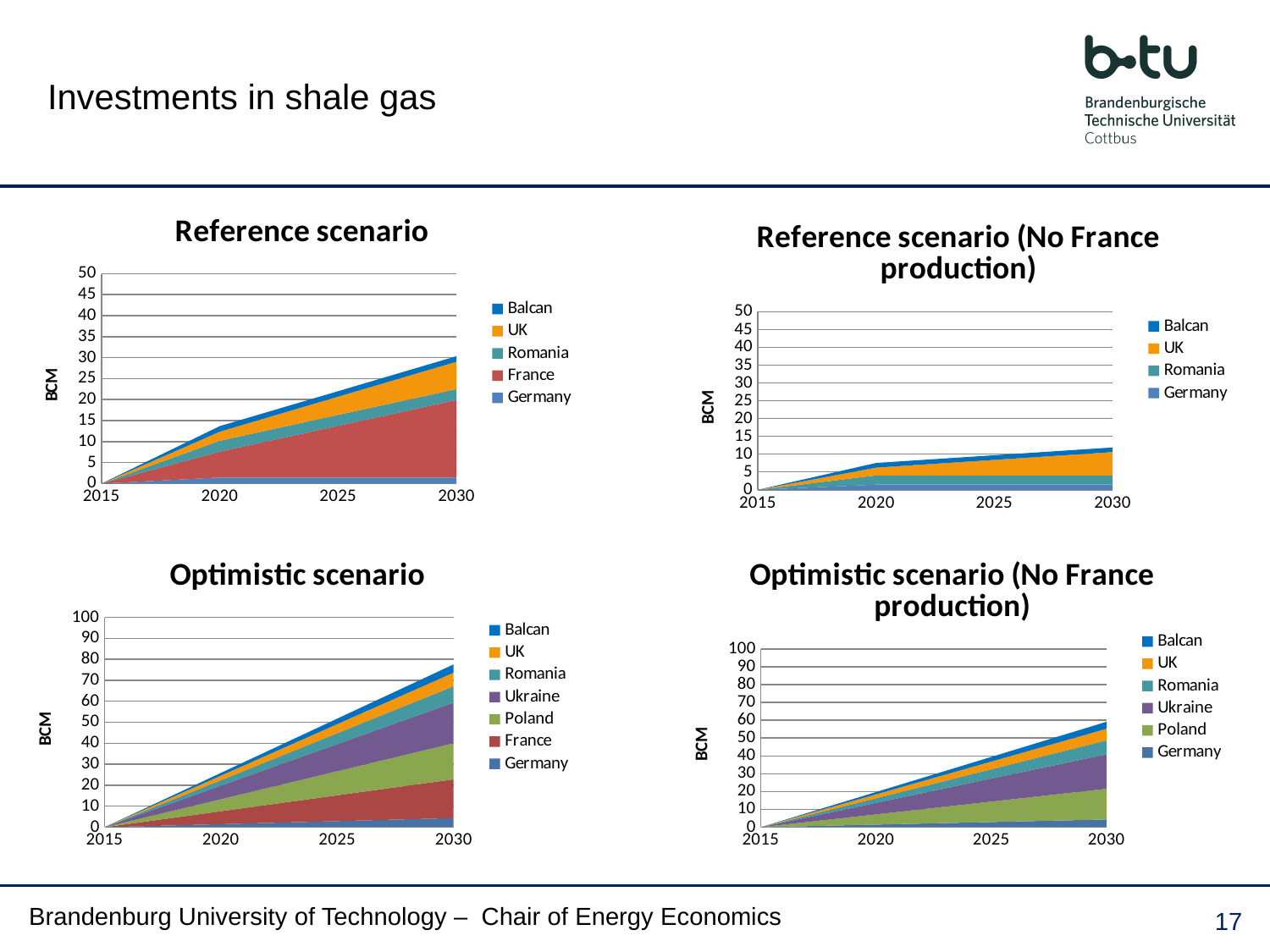
In the Optimistic scenario chart, is the total stacked value in 2030 greater or less than 60? greater In the Optimistic scenario (No France production) chart, is the total stacked value in 2030 greater or less than 70? less How many series does the legend of the Optimistic scenario chart list? 7 Which chart has the larger total stacked value in 2030, the Reference scenario chart or the Optimistic scenario chart? Optimistic scenario How many series does the legend of the Reference scenario (No France production) chart list? 4 What is the y-axis label on the Reference scenario chart? BCM How many series does the legend of the Reference scenario chart list? 5 In the Reference scenario chart, does the total stacked value rise or fall from 2015 to 2030? rise What kind of chart is the Reference scenario chart? stacked area chart In the Reference scenario (No France production) chart, is the total stacked value in 2030 greater or less than 20? less